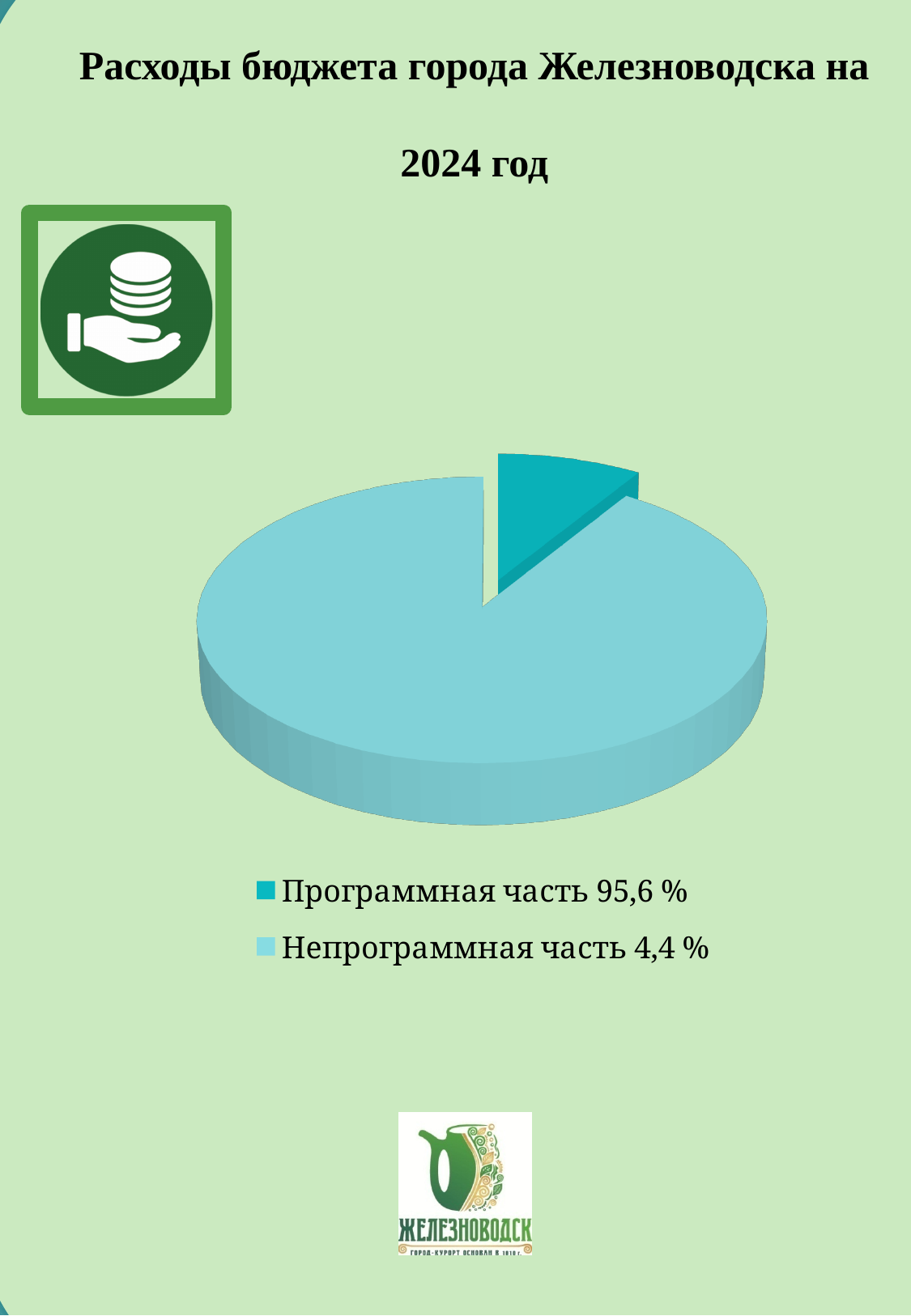
What is the title of the slide? Расходы бюджета города Железноводска на 2024 год What is the total of the two shares shown in the legend? 100 % Which category has the largest share according to the legend? Программная часть What is the difference between the shares of Программная часть and Непрограммная часть? 91,2 % What share is shown for Непрограммная часть? 4,4 % What colour is the legend marker for Непрограммная часть? Light blue Which is larger according to the legend: Программная часть or Непрограммная часть? Программная часть What share is shown for Программная часть? 95,6 % How many entries does the legend list? 2 Which category has the smallest share according to the legend? Непрограммная часть How many categories does the pie chart have? 2 What kind of chart is shown on the slide? Pie chart